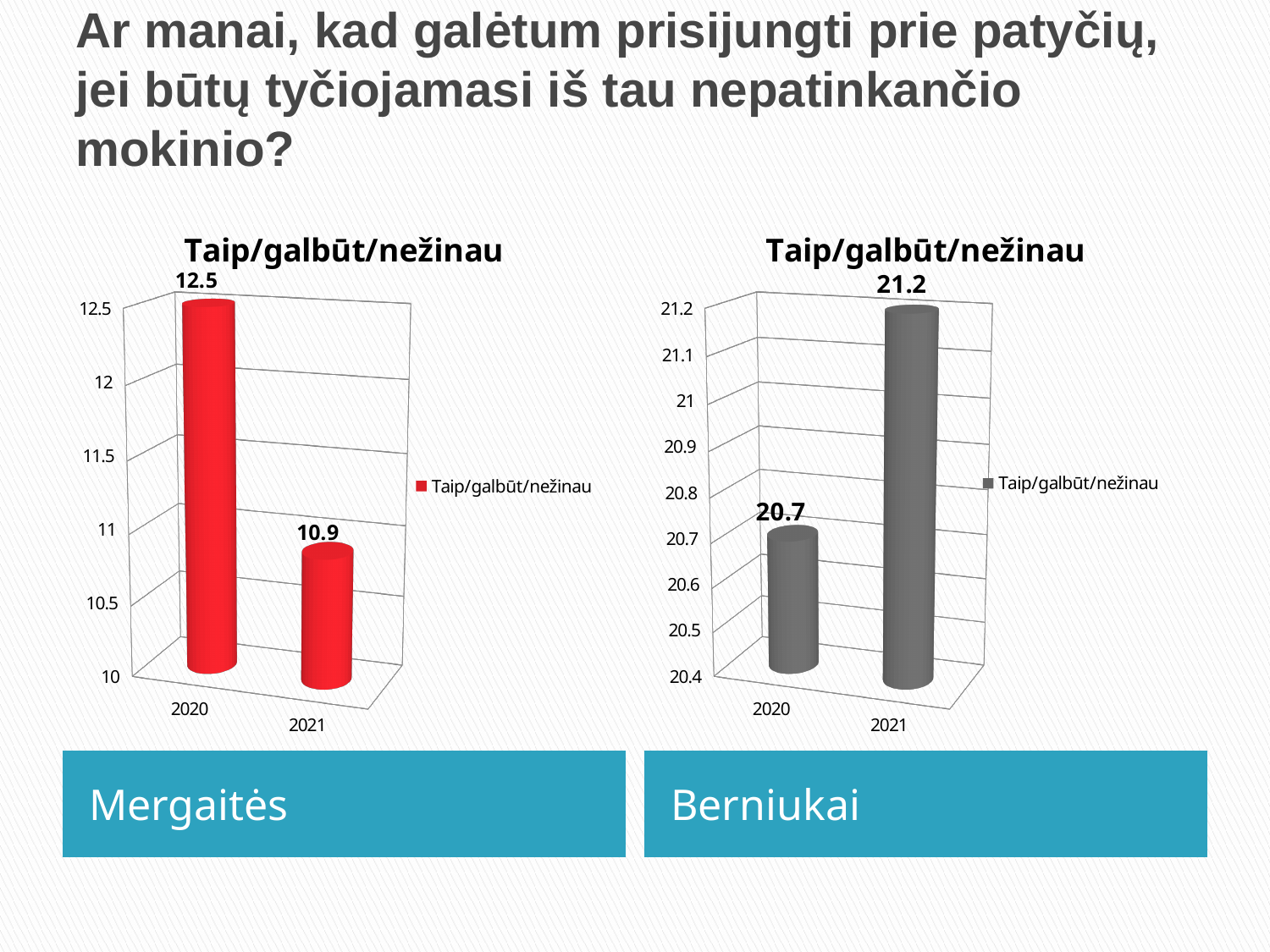
In the right chart (Berniukai), what is the value for 2021? 21.2 In the right chart (Berniukai), what is the difference between the 2021 and 2020 values? 0.5 In the right chart (Berniukai), what is the value for 2020? 20.7 In the left chart (Mergaitės), which year has the higher value? 2020 What type of chart is the left chart (Mergaitės)? bar chart In the left chart (Mergaitės), what is the difference between the 2020 and 2021 values? 1.6 In the right chart (Berniukai), which year has the lower value? 2020 In the left chart (Mergaitės), what is the value for 2021? 10.9 In the left chart (Mergaitės), what is the value for 2020? 12.5 In the left chart (Mergaitės), do the values rise or fall from 2020 to 2021? fall In the right chart (Berniukai), do the values rise or fall from 2020 to 2021? rise How many series does the legend of the right chart (Berniukai) list? 1